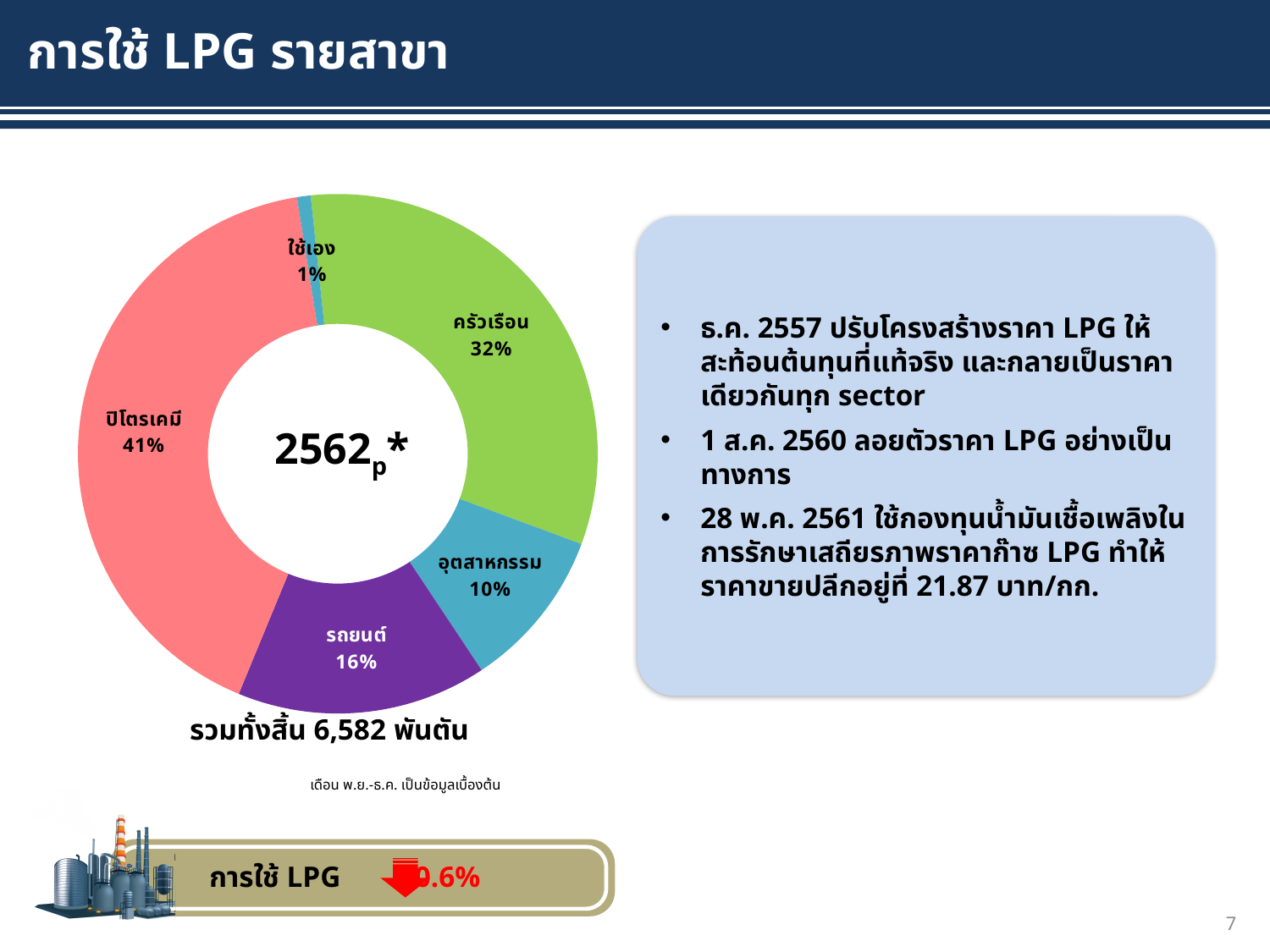
Which sector has the largest share of LPG consumption in the chart? ปิโตรเคมี Which sector has the smallest share of LPG consumption in the chart? ใช้เอง Which has a larger share, รถยนต์ or อุตสาหกรรม? รถยนต์ What percentage is shown for ครัวเรือน in the chart? 32% What kind of chart is used to show LPG consumption by sector? Pie (doughnut) chart What share of LPG consumption does ปิโตรเคมี account for in the chart? 41% What is the difference in percentage points between ปิโตรเคมี and ครัวเรือน? 9 What percentage is shown for รถยนต์ in the chart? 16% What total LPG consumption is stated below the chart? 6,582 พันตัน How many sectors are shown in the chart? 5 What year label is shown in the centre of the chart? 2562p* What percentage is shown for อุตสาหกรรม in the chart? 10%